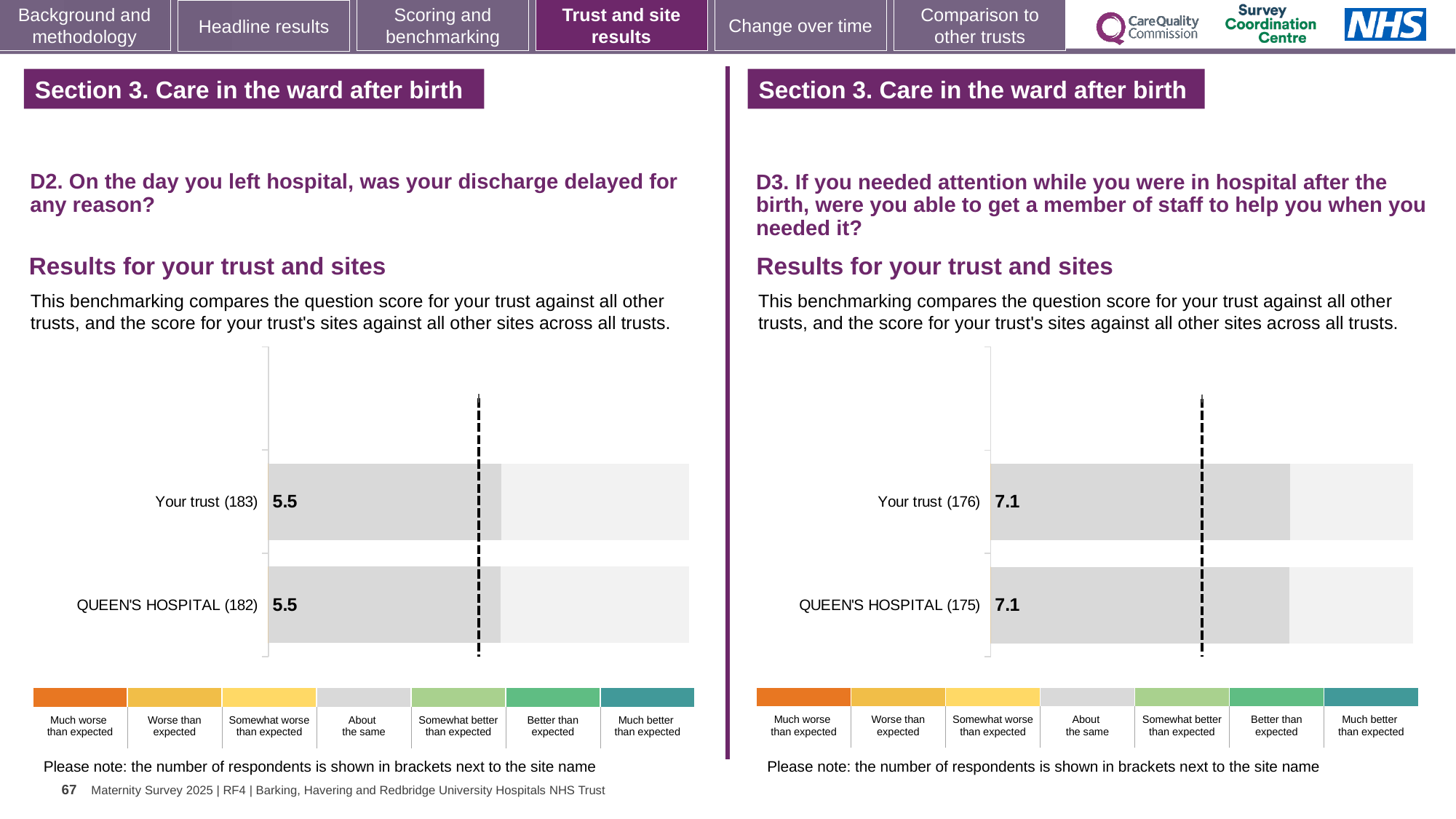
What kind of chart is used in the left chart (D2)? Bar chart In the right chart (D3), what is the difference between the score for Your trust and the score for QUEEN'S HOSPITAL? 0 According to the colour key below the right chart (D3), which benchmark category does the grey bar colour represent? About the same In the left chart (D2), what is the score for QUEEN'S HOSPITAL (182)? 5.5 How many bars are plotted in the right chart (D3)? 2 In the left chart (D2), how many respondents are shown in brackets for QUEEN'S HOSPITAL? 182 In the left chart (D2), what is the score for Your trust (183)? 5.5 In the right chart (D3), what is the score for QUEEN'S HOSPITAL (175)? 7.1 How many bars are plotted in the left chart (D2)? 2 In the right chart (D3), what is the score for Your trust (176)? 7.1 In the right chart (D3), how many respondents are shown in brackets for Your trust? 176 In the left chart (D2), what is the difference between the score for Your trust and the score for QUEEN'S HOSPITAL? 0